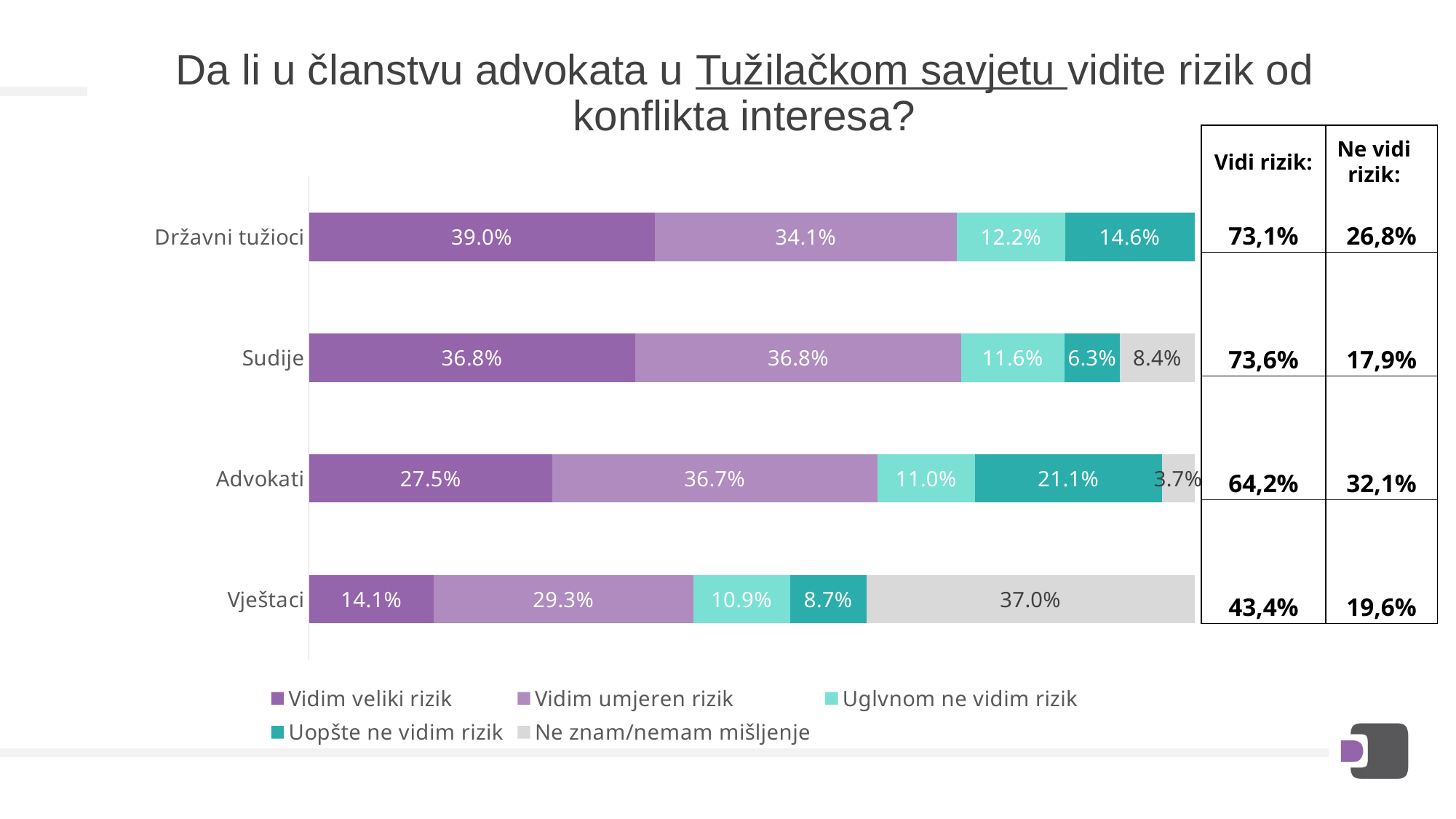
What percentage of Državni tužioci answered "Vidim veliki rizik"? 39.0% Which category has the highest value for "Vidim veliki rizik"? Državni tužioci What is the difference in "Vidim veliki rizik" between Državni tužioci and Vještaci? 24.9 percentage points What percentage of Advokati answered "Uopšte ne vidim rizik"? 21.1% What kind of chart is shown on the slide? Stacked bar chart How many categories (respondent groups) are shown on the chart? 4 Which category has the lowest value for "Vidim veliki rizik"? Vještaci What is the total of the stacked bar for Vještaci? 100.0% Which is larger: "Uglvnom ne vidim rizik" for Državni tužioci or for Vještaci? Državni tužioci What is the difference in "Uopšte ne vidim rizik" between Advokati and Sudije? 14.8 percentage points How many series does the legend list? 5 What is the value of "Ne znam/nemam mišljenje" for Vještaci? 37.0%